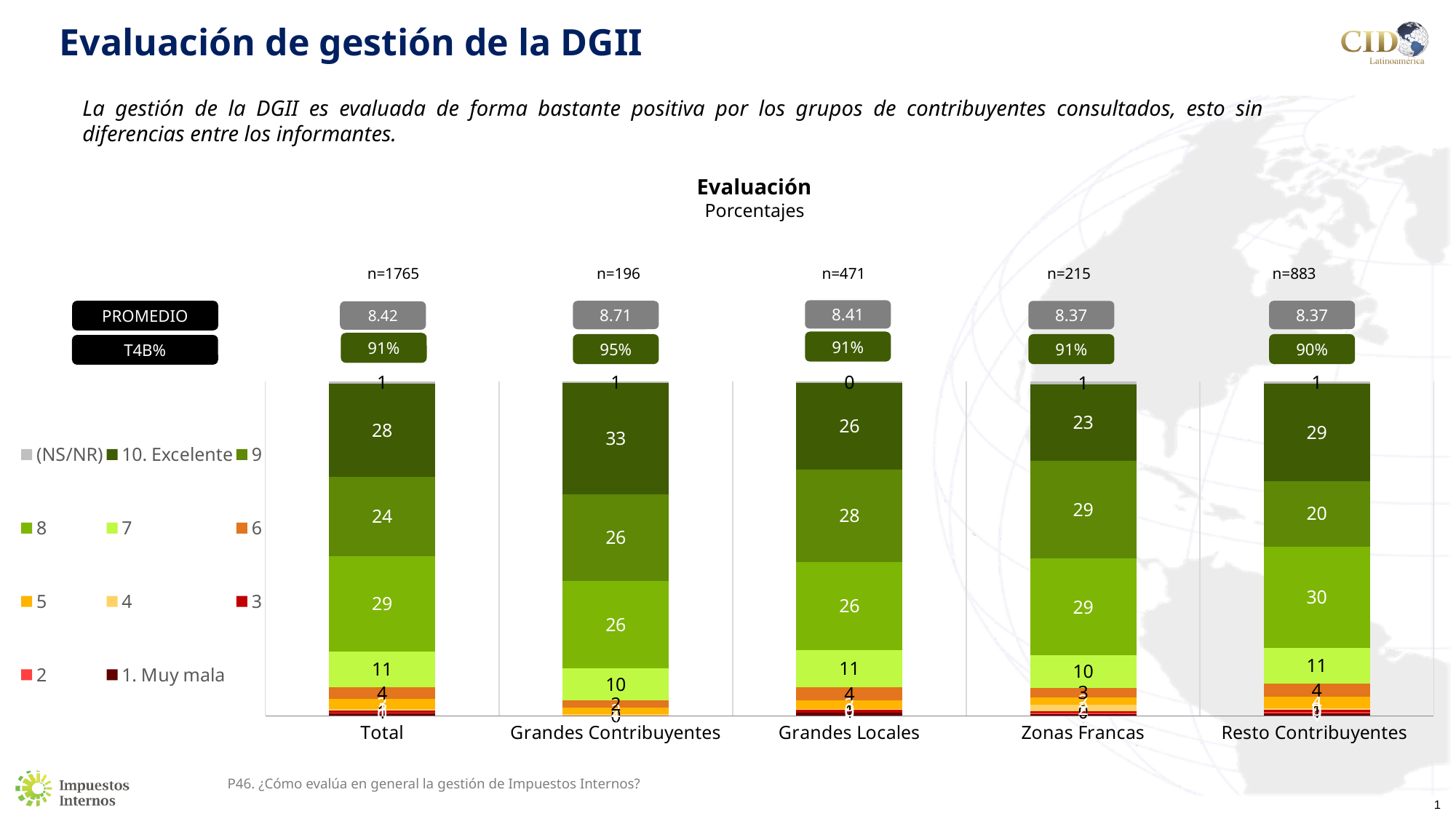
Which category has the lowest value for the '10. Excelente' segment? Zonas Francas What is the PROMEDIO value shown for Grandes Contribuyentes? 8.71 What is the difference between the '10. Excelente' values for Grandes Contribuyentes and Total? 5 Which is larger: the '7' segment for Grandes Locales or the '7' segment for Grandes Contribuyentes? Grandes Locales What kind of chart is shown on the slide? stacked bar chart What is the value of the '10. Excelente' segment for Grandes Contribuyentes? 33 How many categories are shown along the x axis of the chart? 5 How many series does the chart legend list? 11 What is the value of the '9' segment for Resto Contribuyentes? 20 What is the T4B% value shown for Resto Contribuyentes? 90% What is the value of the '8' segment for Zonas Francas? 29 Which category has the highest value for the '10. Excelente' segment? Grandes Contribuyentes